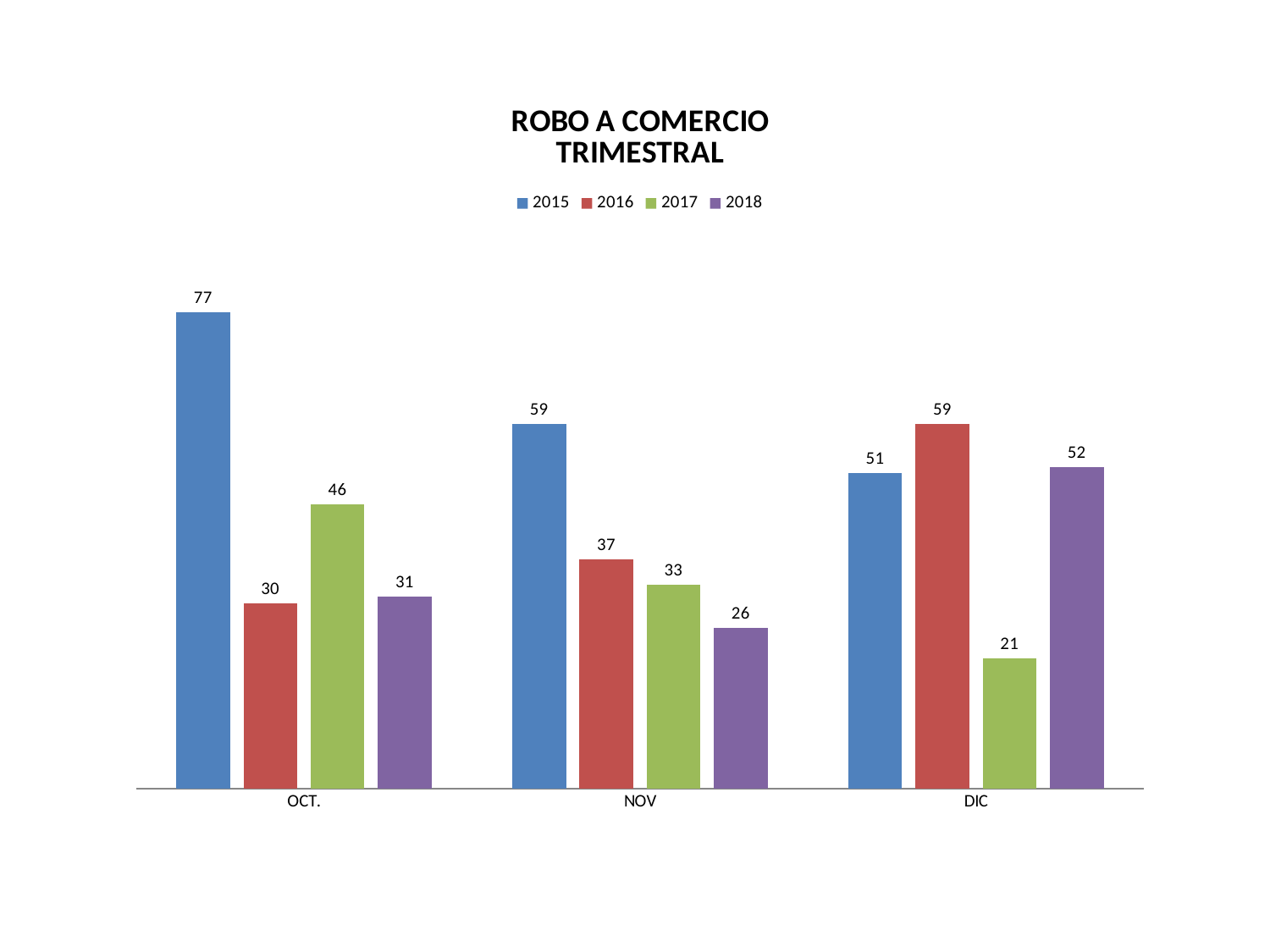
What is the value for 2018 in NOV? 26 What is the value for 2017 in DIC? 21 Which year has the highest value in OCT.? 2015 How many series does the legend list? 4 How many categories are shown on the x axis? 3 Do the values for 2015 rise or fall from OCT. to DIC? Fall Which year has the lowest value in DIC? 2017 Which is larger in NOV: the value for 2016 or the value for 2017? 2016 What kind of chart is shown on the slide? Bar chart What is the value for 2015 in OCT.? 77 What is the difference between the 2015 and 2016 values in OCT.? 47 What is the title of the chart? ROBO A COMERCIO TRIMESTRAL